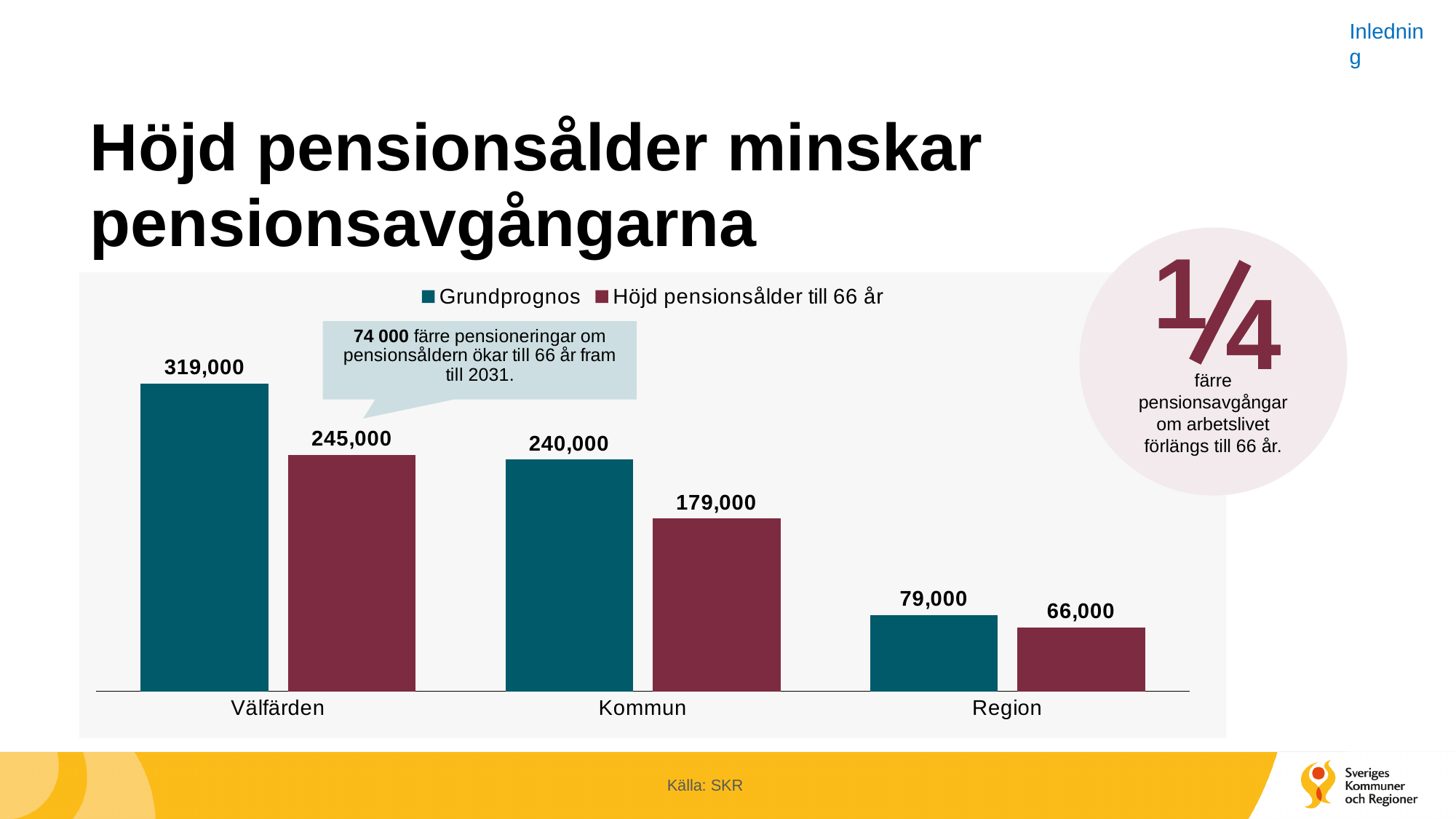
What is the value for Kommun in the Höjd pensionsålder till 66 år series? 179,000 What is the difference between the Grundprognos and Höjd pensionsålder till 66 år values for Välfärden? 74,000 Which colour represents the Grundprognos series? Dark teal Which category has the highest value in the Höjd pensionsålder till 66 år series? Välfärden What is the difference between the Grundprognos and Höjd pensionsålder till 66 år values for Region? 13,000 How many categories are shown on the x axis? 3 What kind of chart is shown on the slide? Bar chart Which category has the lowest Grundprognos value? Region What is the Grundprognos value for Region? 79,000 How many series does the legend list? 2 What is the Grundprognos value for Välfärden? 319,000 Which is larger: the Höjd pensionsålder till 66 år value for Välfärden or the Grundprognos value for Kommun? Höjd pensionsålder till 66 år value for Välfärden